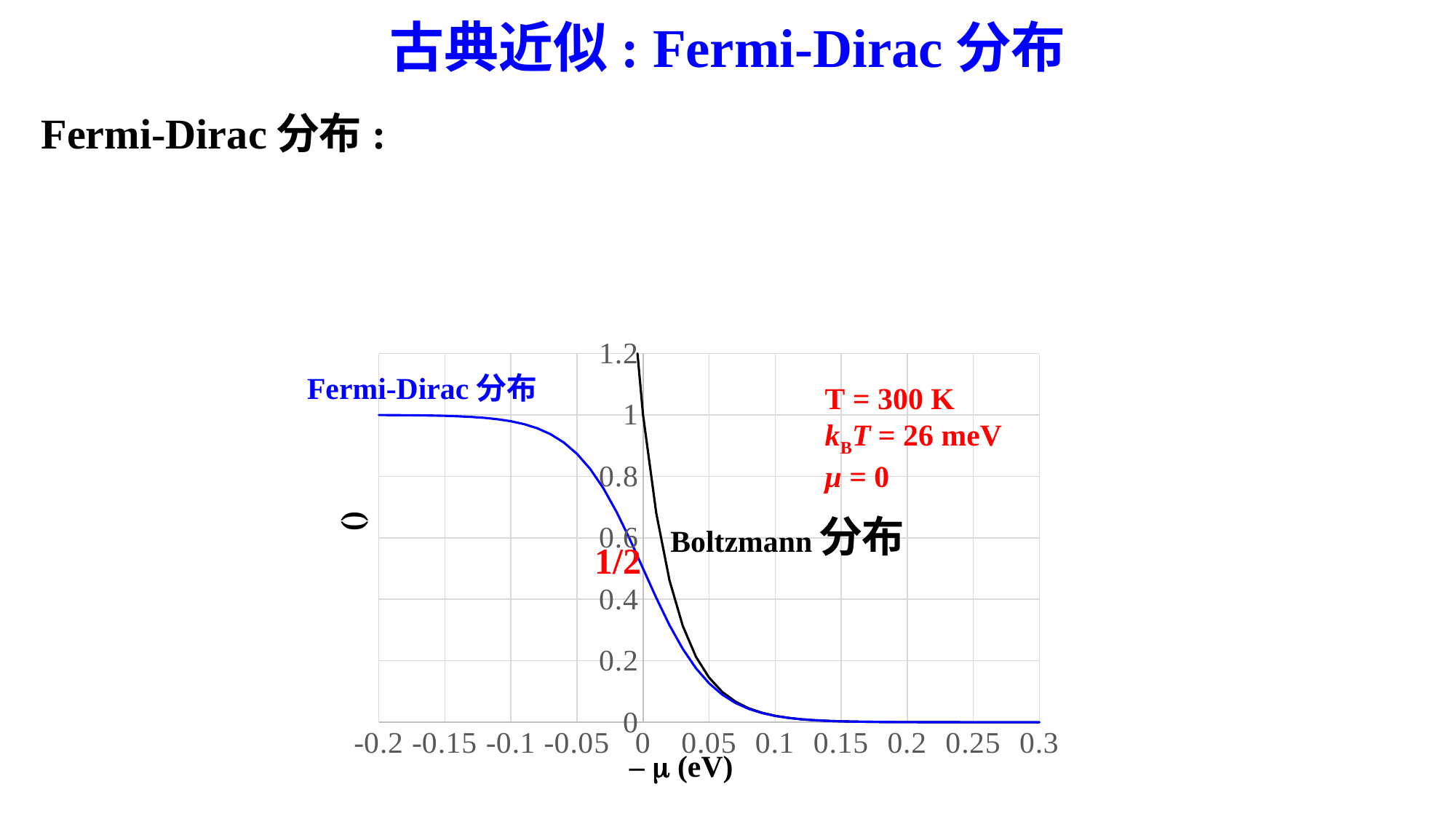
What temperature is stated on the chart? T = 300 K What value of k_B T is stated on the chart? 26 meV What kind of chart is shown on the slide? line chart Is the value of the Fermi-Dirac curve at ε − μ = 0.2 eV greater or less than 0.2? less Do the curves rise or fall as ε − μ increases along the x axis? fall What is the value of the Fermi-Dirac distribution at ε − μ = 0, as marked on the chart? 1/2 At ε − μ = 0.05 eV, which curve is higher, the Fermi-Dirac or the Boltzmann distribution? Boltzmann Is the value of the Fermi-Dirac curve at ε − μ = −0.2 eV greater or less than 0.8? greater Is the value of the Boltzmann curve at ε − μ = 0 greater or less than 0.8? greater How many curves are plotted on the chart? 2